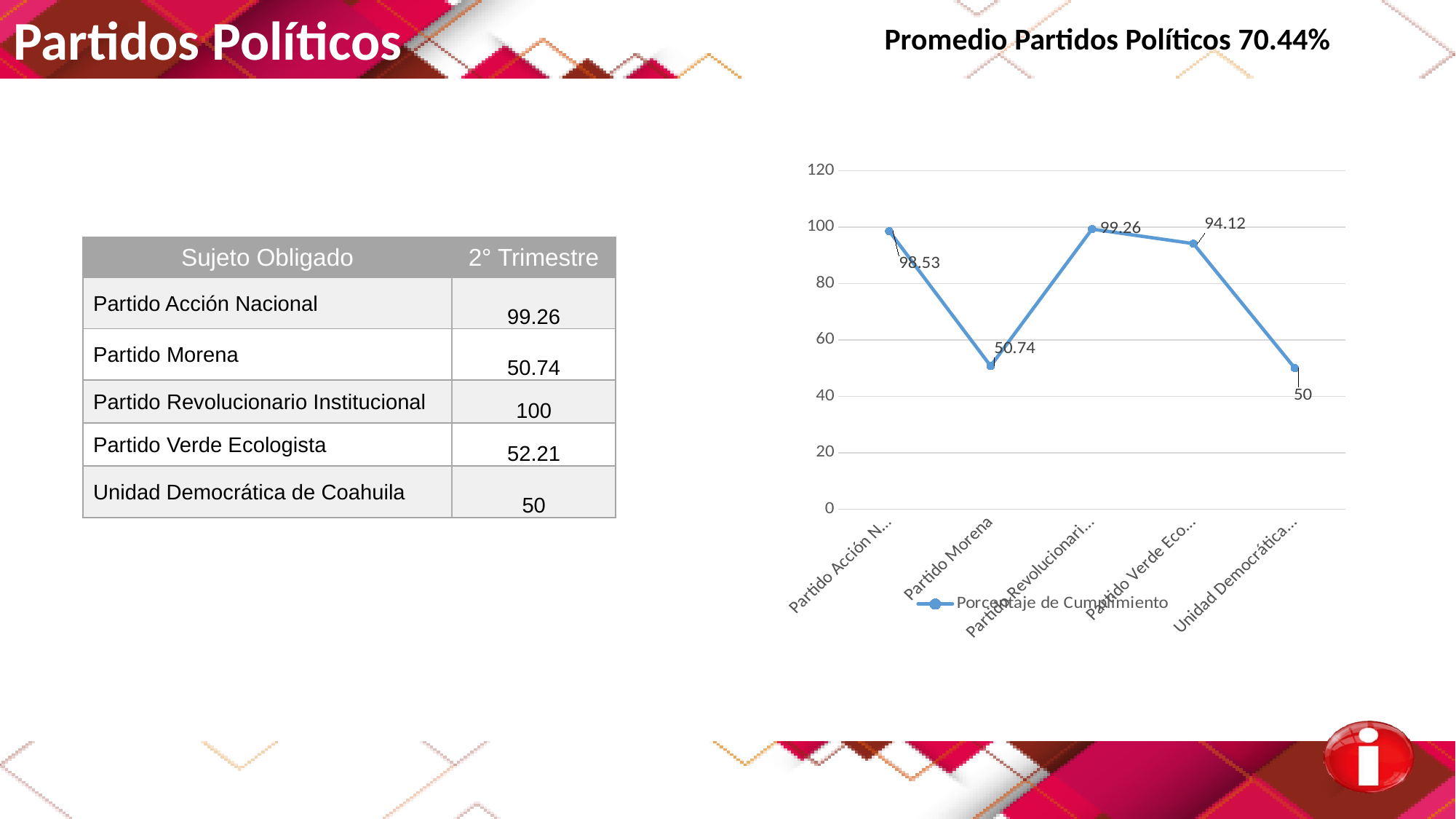
Which category has the highest value in the chart? Partido Revolucionario Institucional What is the value plotted for Partido Acción Nacional in the chart? 98.53 Which has a larger value in the chart, Partido Verde Ecologista or Partido Morena? Partido Verde Ecologista What series name does the chart legend show? Porcentaje de Cumplimiento What is the value plotted for Partido Verde Ecologista in the chart? 94.12 Which category has the lowest value in the chart? Unidad Democrática de Coahuila How many data points are plotted in the chart? 5 What is the difference between the chart values for Partido Revolucionario Institucional and Partido Morena? 48.52 What kind of chart is shown on the slide? line chart What is the value plotted for Partido Morena in the chart? 50.74 Is the value for Partido Morena in the chart greater or less than 60? less What is the value plotted for Unidad Democrática de Coahuila in the chart? 50